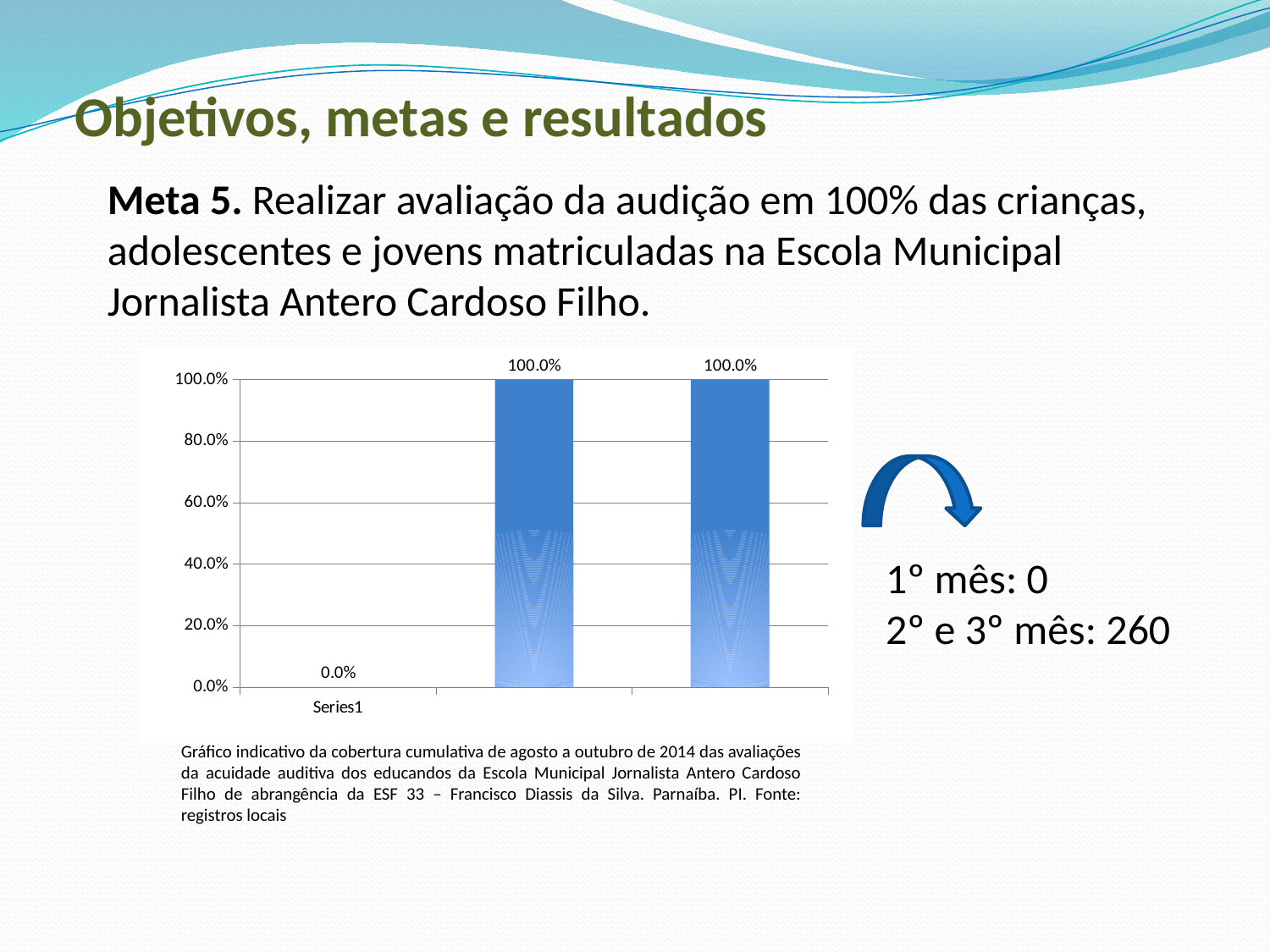
What is the value of the leftmost bar, labelled Series1? 0.0% How many bars are plotted in the chart? 3 What is the value of the middle bar in the chart? 100.0% What is the value of the rightmost bar in the chart? 100.0% Do the values rise or fall from left to right across the chart? rise What is the difference between the value of the middle bar and the leftmost bar? 100.0% What is the highest tick value shown on the vertical axis of the chart? 100.0% What is the only category label shown on the horizontal axis of the chart? Series1 Which bar has the lowest value in the chart? the leftmost bar (Series1) What kind of chart is shown on the slide? bar chart Which is larger, the value of the leftmost bar or the value of the rightmost bar? the rightmost bar